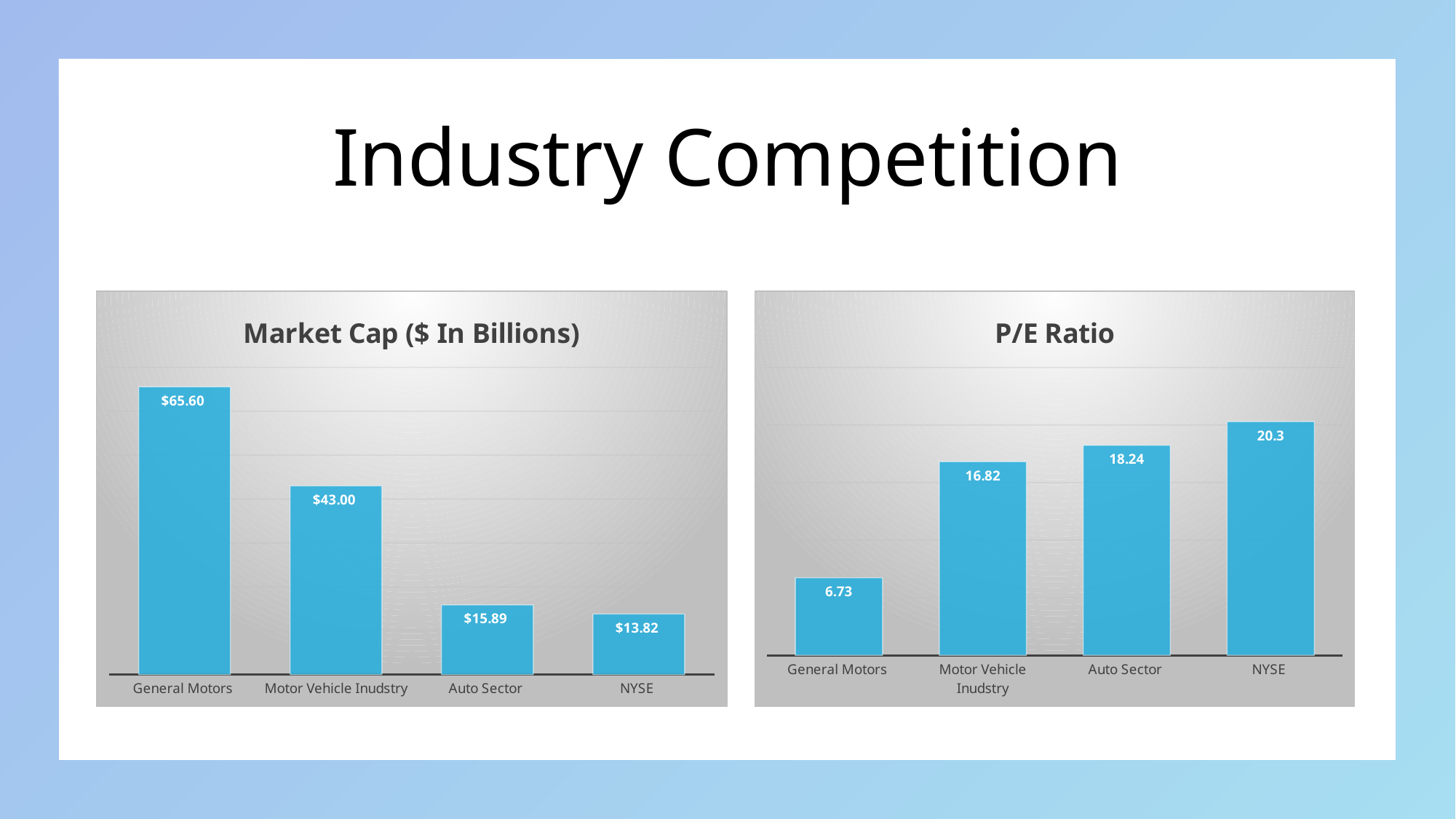
In the P/E Ratio chart, what is the value for Auto Sector? 18.24 How many categories are shown in the P/E Ratio chart? 4 In the P/E Ratio chart, which category has the highest value? NYSE In the Market Cap ($ In Billions) chart, what is the value for General Motors? $65.60 In the Market Cap ($ In Billions) chart, which category has the highest value? General Motors In the P/E Ratio chart, what is the difference between NYSE and General Motors? 13.57 In the Market Cap ($ In Billions) chart, what is the difference between General Motors and Motor Vehicle Inudstry? $22.60 In the Market Cap ($ In Billions) chart, what is the value for NYSE? $13.82 In the Market Cap ($ In Billions) chart, which is larger, Auto Sector or NYSE? Auto Sector In the P/E Ratio chart, which category has the lowest value? General Motors What kind of chart is the Market Cap ($ In Billions) chart? Bar chart In the P/E Ratio chart, what is the value for General Motors? 6.73